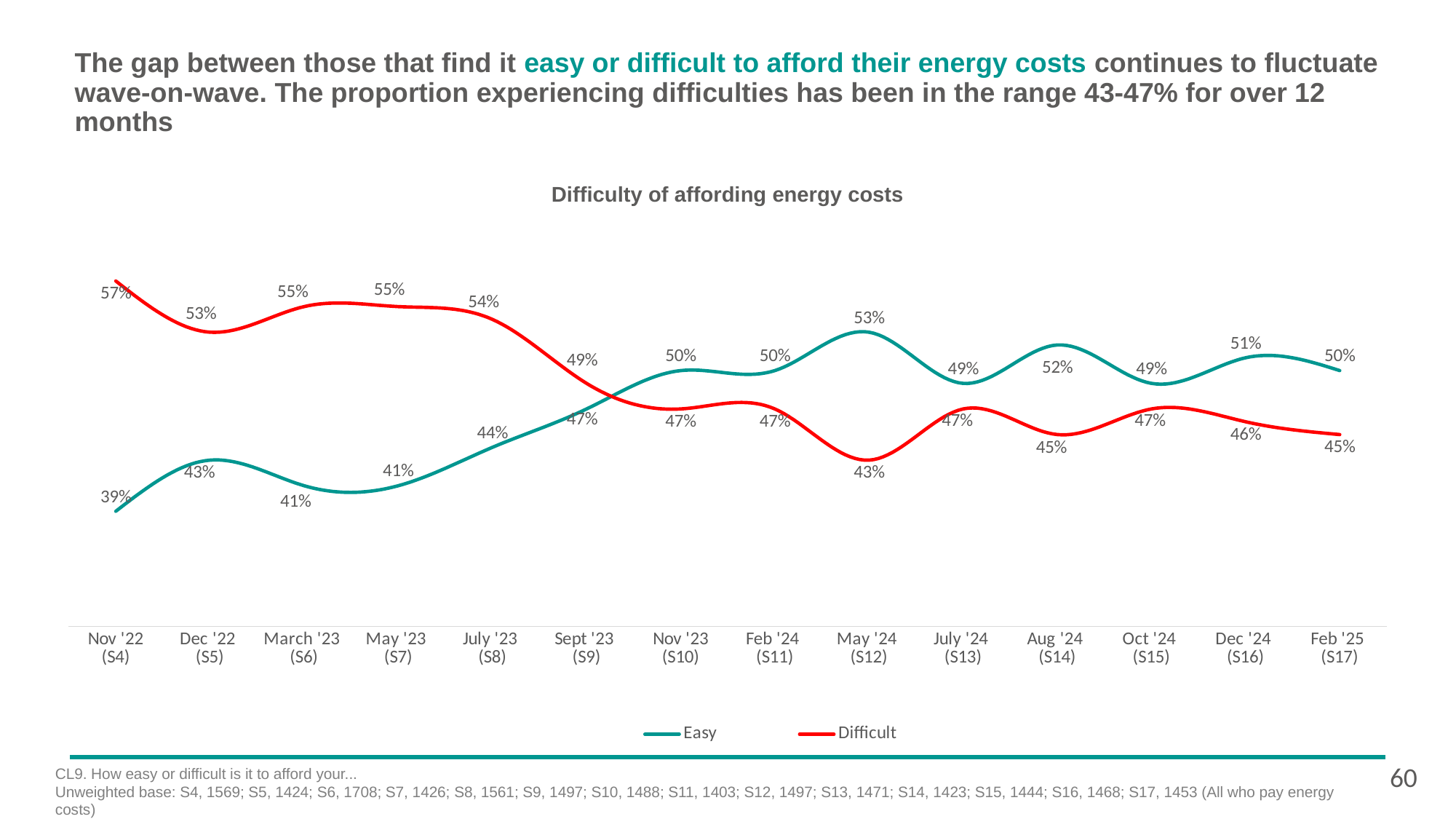
How many waves (time points) are shown on the x axis? 14 In which wave is the Difficult series at its lowest value? May '24 (S12) What kind of chart is shown on the slide? Line chart How many series does the legend list? 2 What is the value for Easy in Nov '22 (S4)? 39% In which wave does the Easy series reach its highest value? May '24 (S12) What is the value for Difficult in Nov '22 (S4)? 57% What is the value for Difficult in May '24 (S12)? 43% What is the title of the chart? Difficulty of affording energy costs What is the difference between the Difficult and Easy values in Nov '22 (S4)? 18 percentage points In Feb '25 (S17), which series has the higher value, Easy or Difficult? Easy What is the value for Easy in Feb '25 (S17)? 50%